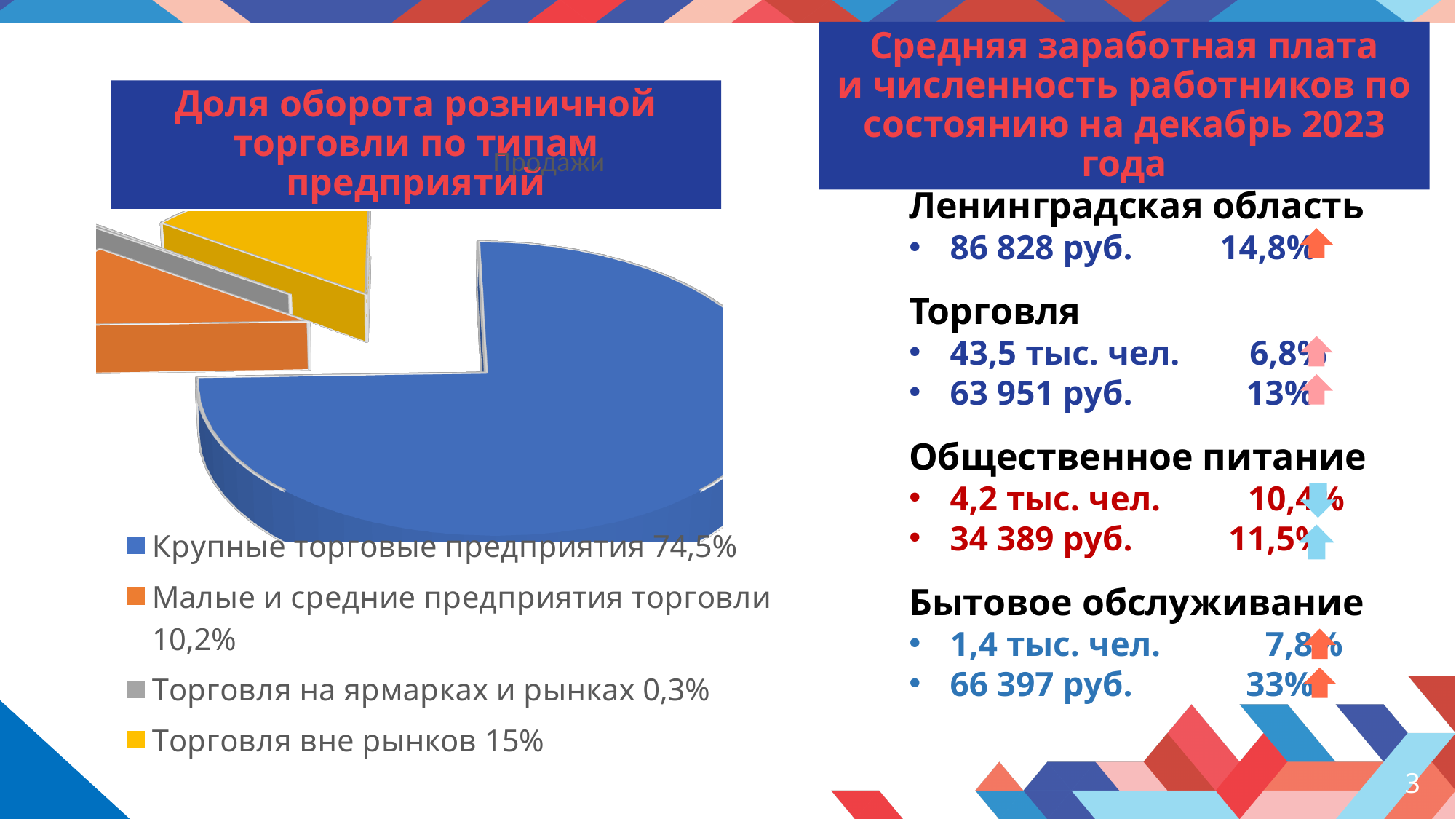
How many categories does the pie chart's legend list? 4 What share is shown for 'Торговля на ярмарках и рынках'? 0,3% What share is shown for 'Малые и средние предприятия торговли'? 10,2% What share of retail turnover is attributed to 'Крупные торговые предприятия'? 74,5% Which is larger: the share of 'Торговля вне рынков' or the share of 'Малые и средние предприятия торговли'? Торговля вне рынков What colour is the slice for 'Торговля вне рынков'? Yellow Which category has the smallest share of the pie? Торговля на ярмарках и рынках What kind of chart is shown on the slide? Pie chart What share is shown for 'Торговля вне рынков'? 15% What is the title shown above the pie chart? Доля оборота розничной торговли по типам предприятий Which category has the largest share of the pie? Крупные торговые предприятия What is the difference between the shares of 'Торговля вне рынков' and 'Малые и средние предприятия торговли'? 4,8%